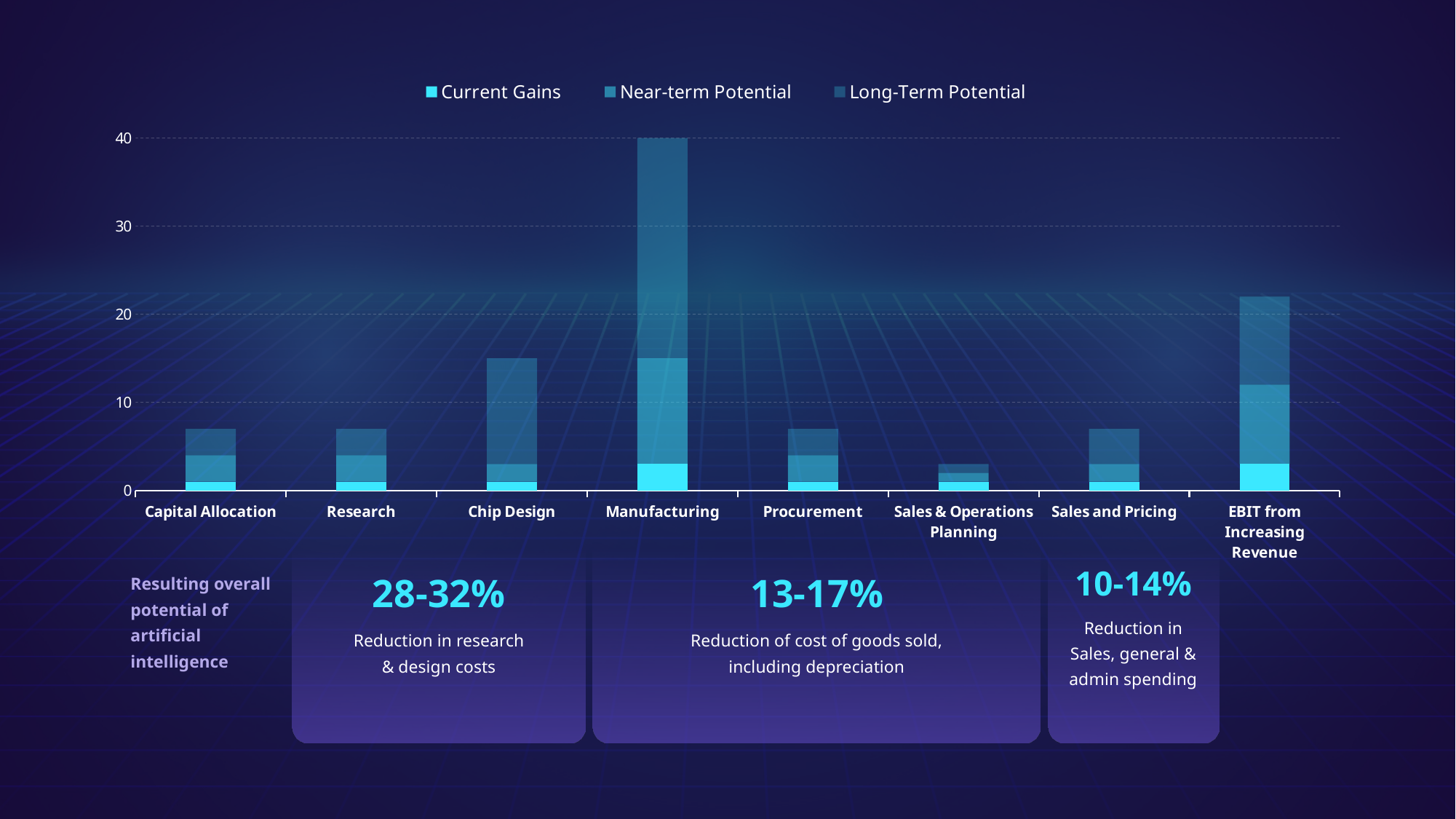
What are the three series named in the chart legend? Current Gains, Near-term Potential, Long-Term Potential How many series does the chart legend list? 3 Is the total stacked value for Manufacturing greater or less than 30? greater Which series is shown at the bottom of each stacked bar? Current Gains Is the total stacked value for Sales & Operations Planning greater or less than 10? less Is the total stacked value for EBIT from Increasing Revenue greater or less than 20? greater Which category has the tallest stacked bar? Manufacturing What kind of chart is shown on the slide? Stacked bar chart Which category has the shortest stacked bar? Sales & Operations Planning How many categories are shown on the x axis of the chart? 8 Which stacked bar is taller, Chip Design or Capital Allocation? Chip Design Which stacked bar is taller, EBIT from Increasing Revenue or Procurement? EBIT from Increasing Revenue